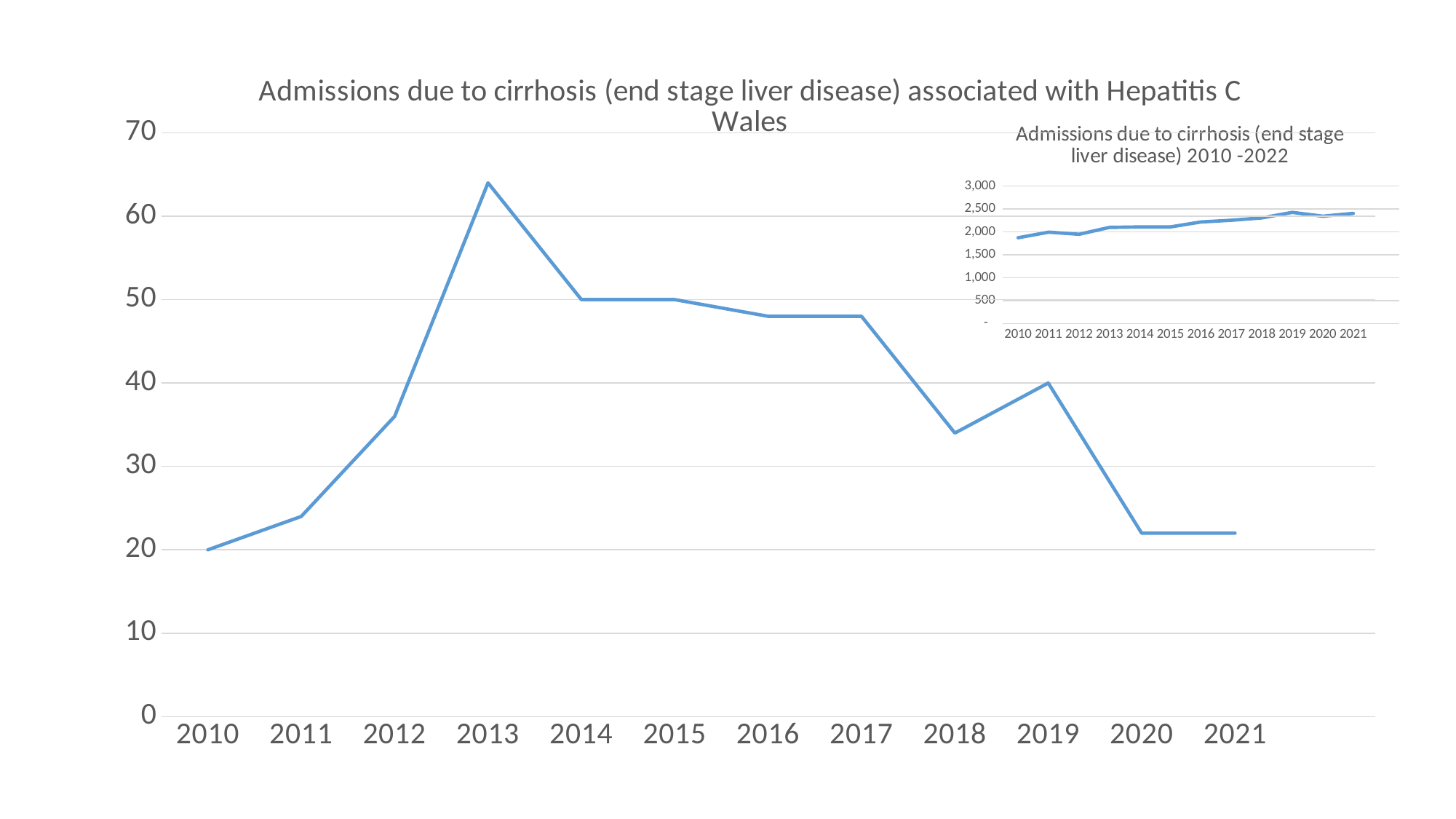
On the main chart (Hepatitis C Wales), what kind of chart is shown? line chart On the small inset chart (2010 -2022), is the value for 2010 greater or less than 2,000? less On the main chart (Hepatitis C Wales), which is larger, the value for 2013 or the value for 2019? 2013 On the main chart (Hepatitis C Wales), how many years are plotted on the x axis? 12 On the main chart (Hepatitis C Wales), is the value for 2012 greater or less than 30? greater On the main chart titled 'Admissions due to cirrhosis (end stage liver disease) associated with Hepatitis C Wales', which year has the highest value? 2013 On the main chart (Hepatitis C Wales), is the value for 2013 greater or less than 60? greater On the main chart (Hepatitis C Wales), do the values rise or fall from 2013 to 2018? fall On the small inset chart (2010 -2022), how many years are shown on the x axis? 12 On the small inset chart titled 'Admissions due to cirrhosis (end stage liver disease) 2010 -2022', do the values generally rise or fall from 2010 to 2021? rise